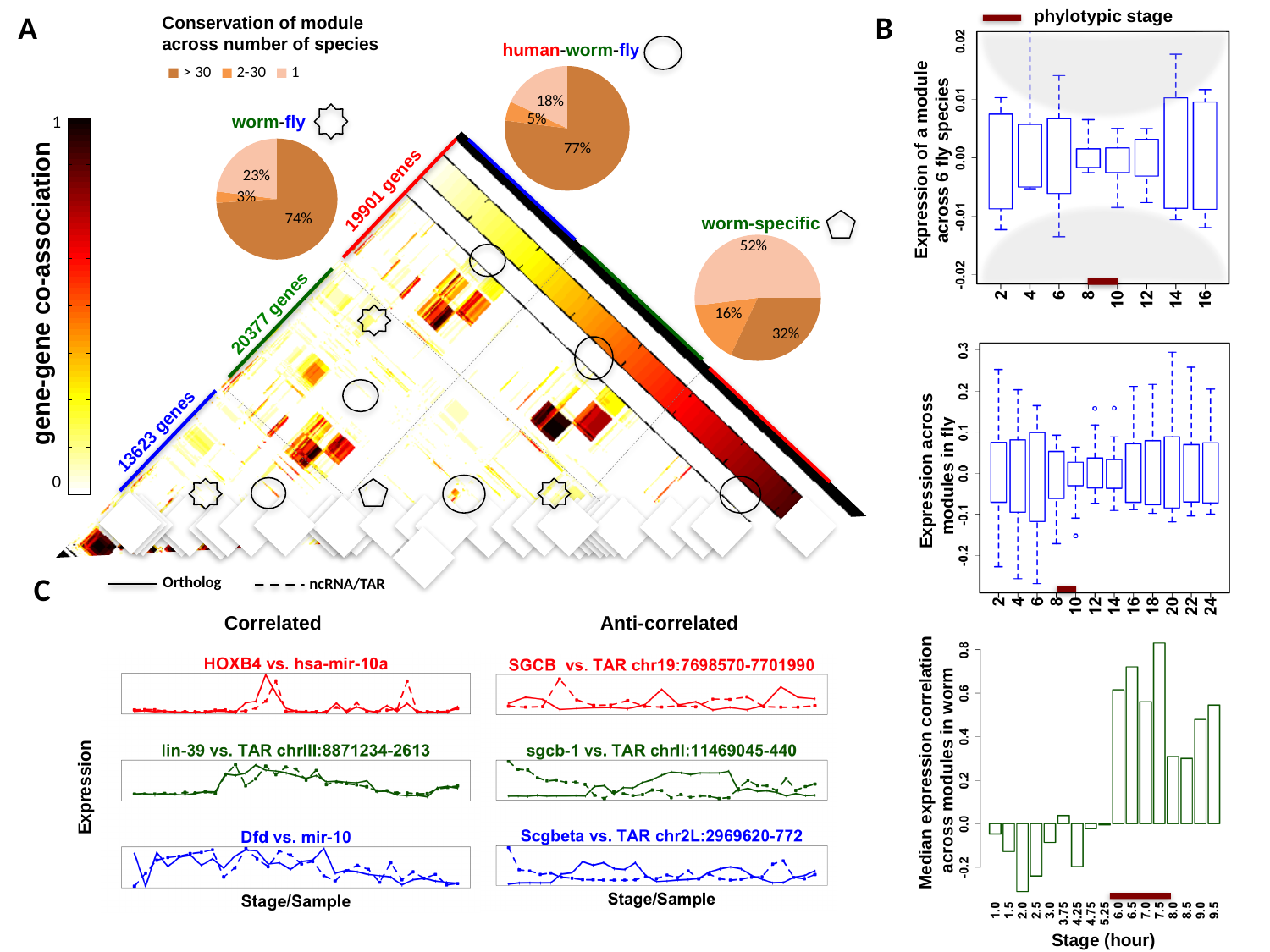
How many boxes are shown in the box plot of expression across modules in fly (x axis 2 to 24)? 12 In the worm-specific pie chart, what is the smallest slice's percentage? 16% In the bar chart of median expression correlation across modules in worm, which stage (hour) has the highest bar? 7.5 Which pie chart has the larger share for modules conserved in only 1 species, worm-fly or worm-specific? worm-specific In the bar chart of median expression correlation across modules in worm, is the value at stage 6.5 greater or less than 0.6? greater In the human-worm-fly pie chart, what is the difference between the largest slice and the 18% slice? 59% How many categories does the 'Conservation of module across number of species' legend list? 3 In the worm-fly pie chart, what share of modules is conserved across more than 30 species? 74% In the human-worm-fly pie chart, what share of modules is conserved across 2-30 species? 5% In the worm-specific pie chart, what is the largest slice's percentage? 52% In the bar chart of median expression correlation across modules in worm, is the value at stage 2.5 greater or less than -0.2? less How many stages (bars) are shown in the bar chart of median expression correlation across modules in worm? 17